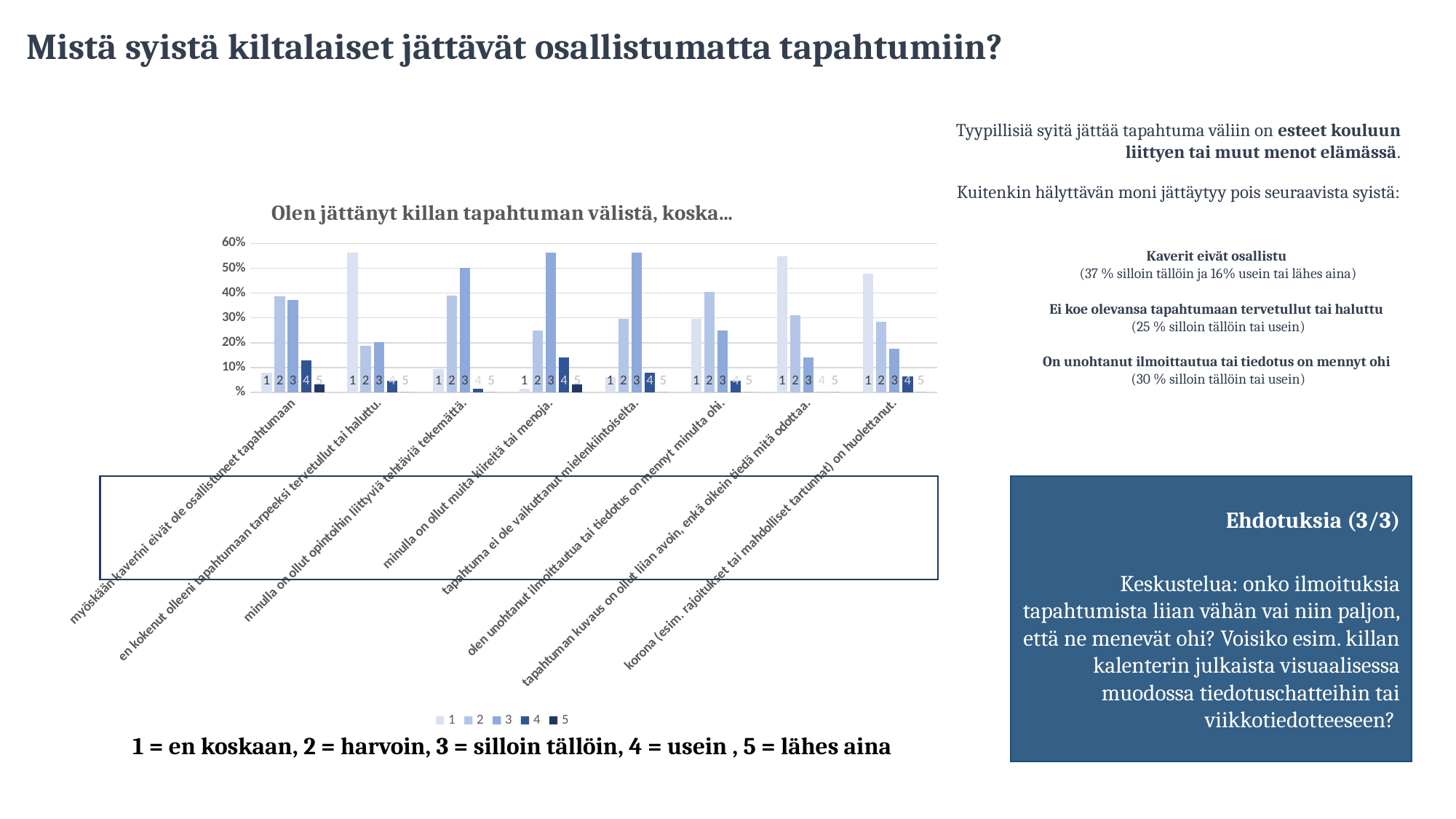
How many series does the chart legend list? 5 Is the value for series 1 in the category 'en kokenut olleeni tapahtumaan tarpeeksi tervetullut tai haluttu.' greater or less than 50%? greater What is the title of the chart? Olen jättänyt killan tapahtuman välistä, koska... What kind of chart is shown on the slide? bar chart Is the value for series 5 in the category 'myöskään kaverini eivät ole osallistuneet tapahtumaan' greater or less than 10%? less What are the legend entries of the chart? 1, 2, 3, 4, 5 Is the value for series 3 in the category 'minulla on ollut muita kiireitä tai menoja.' greater or less than 50%? greater In the category 'en kokenut olleeni tapahtumaan tarpeeksi tervetullut tai haluttu.', which is larger: the value for series 1 or series 3? series 1 How many categories (reasons) are shown along the x axis of the chart? 8 In the category 'minulla on ollut muita kiireitä tai menoja.', which is larger: the value for series 2 or series 3? series 3